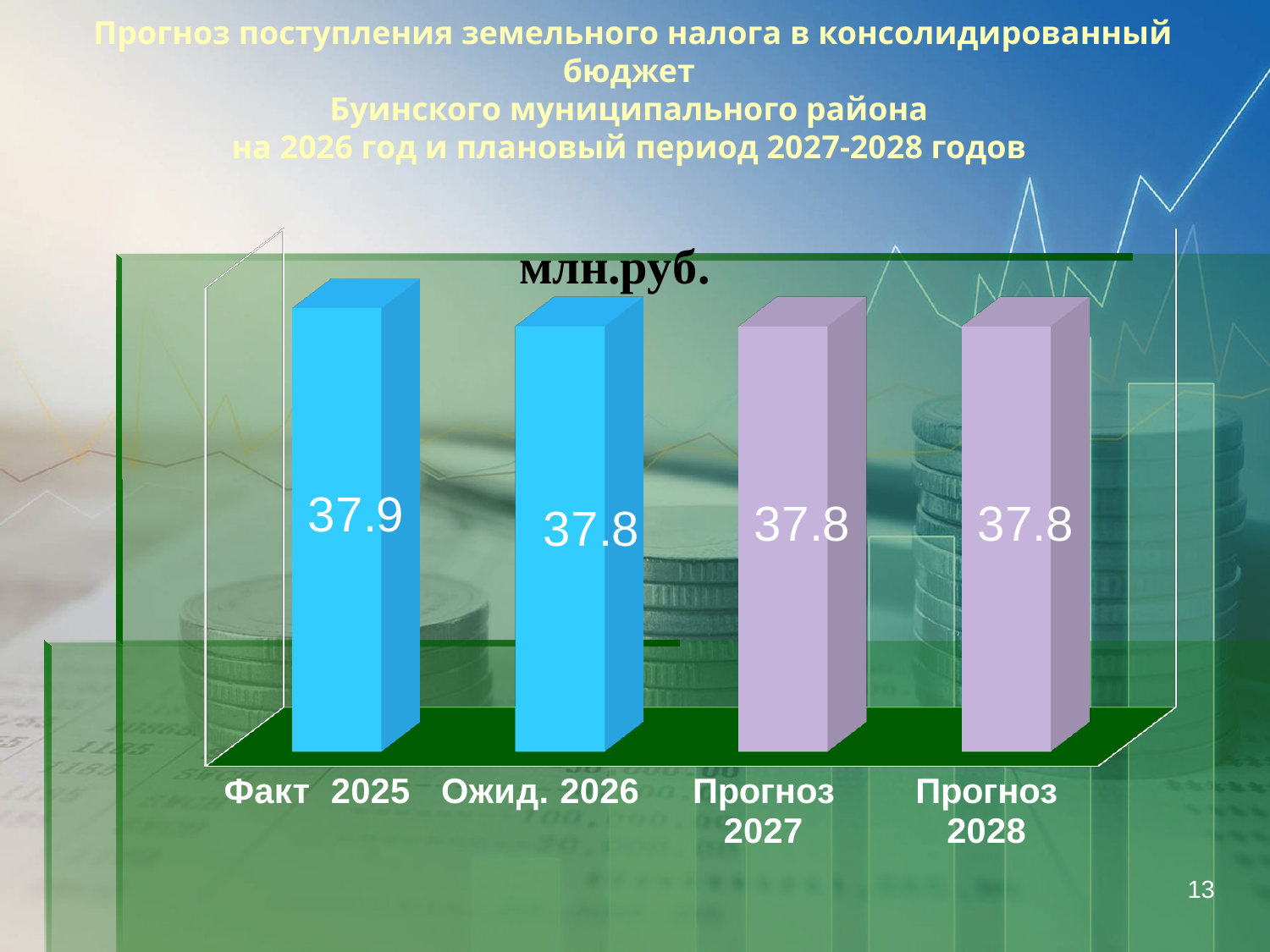
What unit is given in the chart title? млн.руб. What is the value for Ожид. 2026? 37.8 How many categories are shown on the chart? 4 What kind of chart is shown on the slide? bar chart What is the value for Факт 2025? 37.9 What colour are the bars for Прогноз 2027 and Прогноз 2028? purple What is the value for Прогноз 2028? 37.8 Do the values rise or fall from Факт 2025 to Ожид. 2026? fall What is the value for Прогноз 2027? 37.8 What is the difference between the values for Факт 2025 and Ожид. 2026? 0.1 Which category has the highest value? Факт 2025 Which is larger, the value for Факт 2025 or the value for Прогноз 2028? Факт 2025